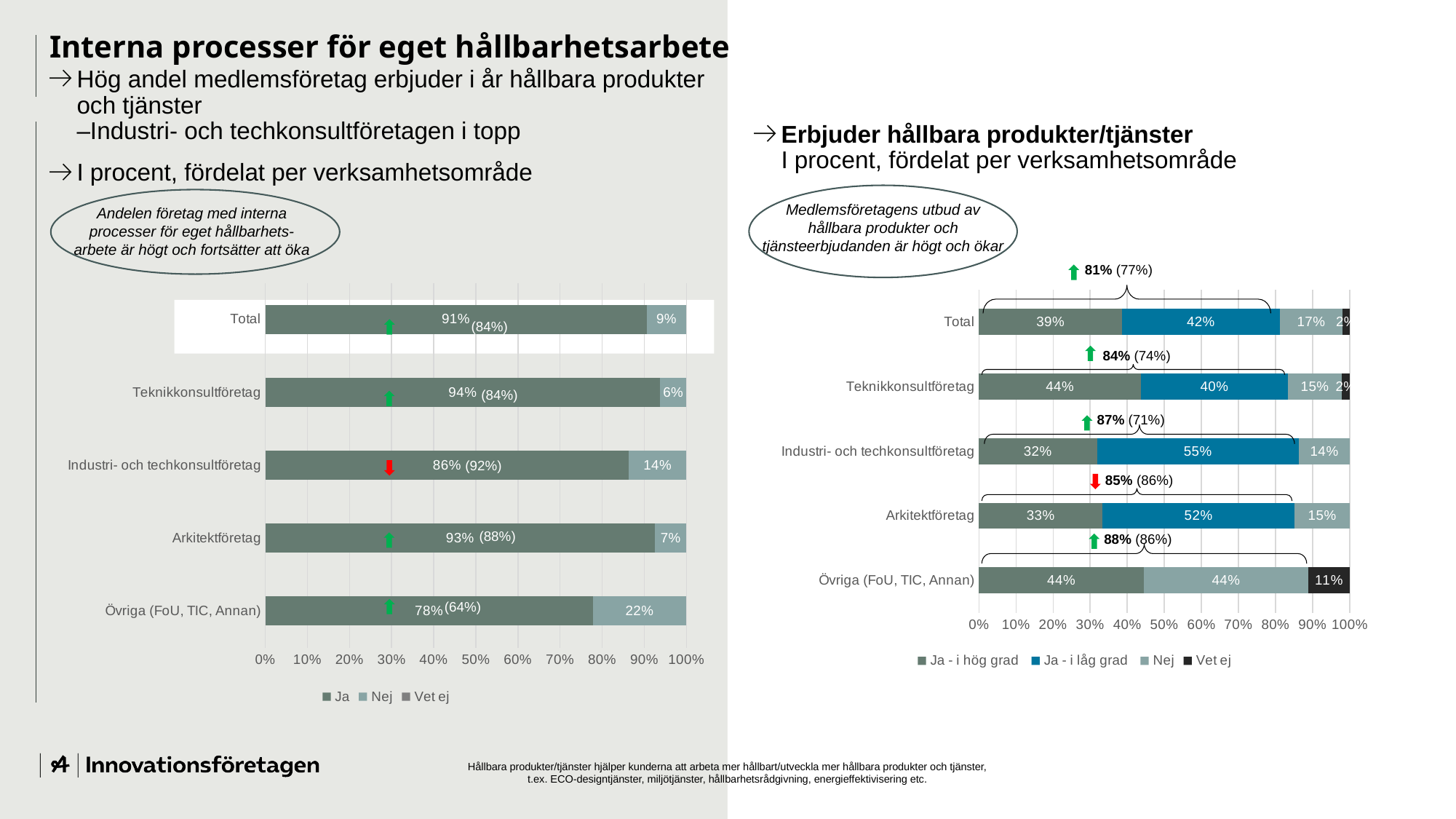
In the right chart (Erbjuder hållbara produkter/tjänster), is the 'Ja - i hög grad' value for Teknikkonsultföretag larger or smaller than that for Arkitektföretag? larger In the right chart (Erbjuder hållbara produkter/tjänster), what is the 'Nej' value for Total? 17% In the right chart (Erbjuder hållbara produkter/tjänster), which category has the highest 'Ja - i låg grad' value? Industri- och techkonsultföretag In the left chart (Interna processer för eget hållbarhetsarbete), what is the 'Ja' value for Teknikkonsultföretag? 94% In the left chart (Interna processer för eget hållbarhetsarbete), which category has the highest 'Ja' value? Teknikkonsultföretag In the left chart (Interna processer för eget hållbarhetsarbete), which category has the lowest 'Ja' value? Övriga (FoU, TIC, Annan) In the right chart (Erbjuder hållbara produkter/tjänster), what is the 'Ja - i låg grad' value for Industri- och techkonsultföretag? 55% In the right chart (Erbjuder hållbara produkter/tjänster), how many categories are shown on the y axis? 5 In the left chart (Interna processer för eget hållbarhetsarbete), how many series does the legend list? 3 In the left chart (Interna processer för eget hållbarhetsarbete), what is the difference between the 'Ja' values for Arkitektföretag and Industri- och techkonsultföretag? 7 percentage points In the left chart (Interna processer för eget hållbarhetsarbete), what is the 'Nej' value for Övriga (FoU, TIC, Annan)? 22% What kind of chart is the right chart (Erbjuder hållbara produkter/tjänster)? Stacked bar chart